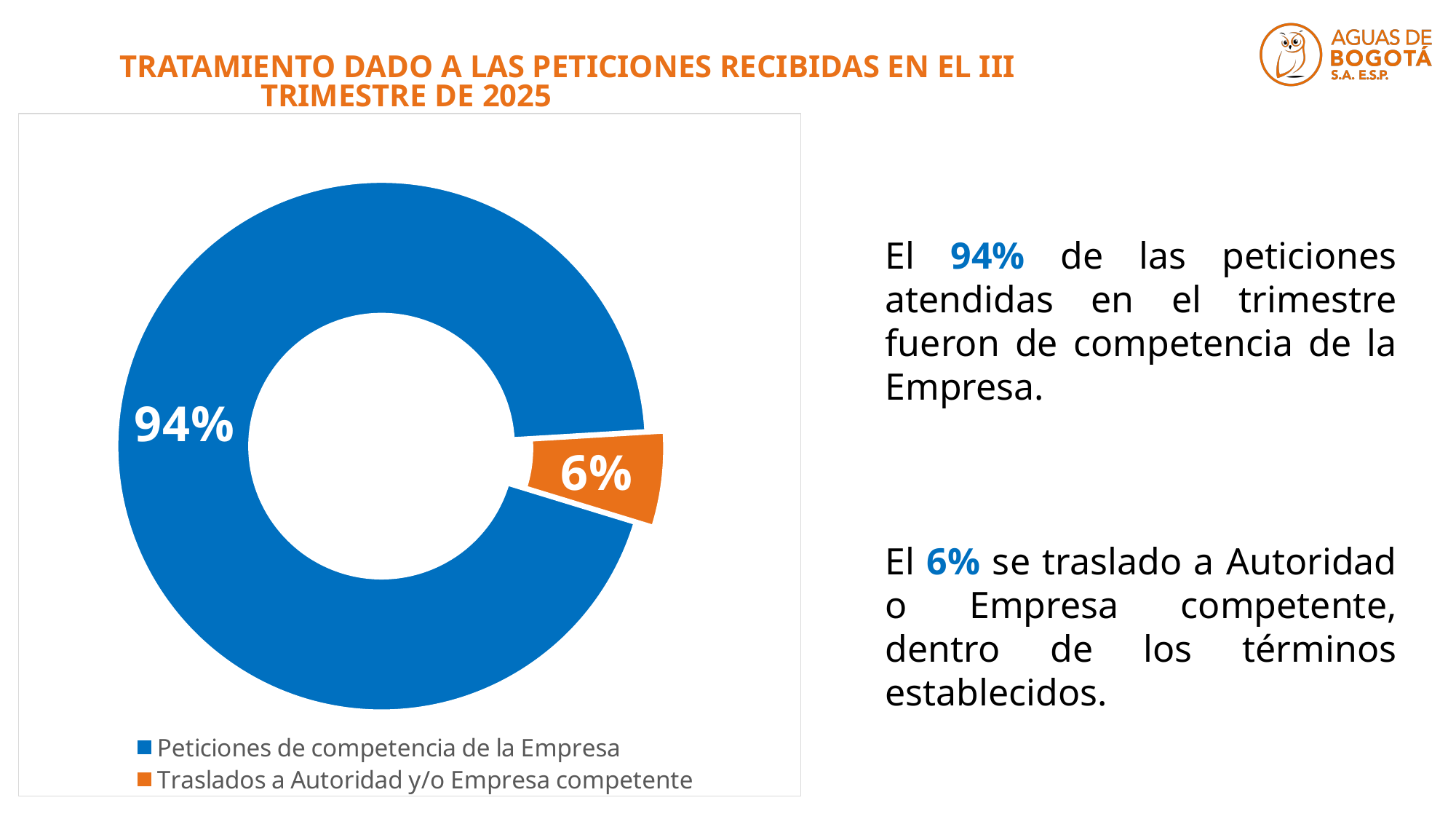
What is the difference in percentage points between the 'Peticiones de competencia de la Empresa' slice and the 'Traslados a Autoridad y/o Empresa competente' slice? 88 What colour is the slice for 'Traslados a Autoridad y/o Empresa competente'? Orange What colour is the slice for 'Peticiones de competencia de la Empresa'? Blue What is the total of the two slices shown in the pie chart? 100% Which category has the smallest slice of the pie? Traslados a Autoridad y/o Empresa competente What kind of chart is shown on the slide? Pie chart (doughnut) What share of the pie is labelled 'Peticiones de competencia de la Empresa'? 94% Which category has the largest slice of the pie? Peticiones de competencia de la Empresa How many categories does the pie chart show? 2 Which is larger: the slice for 'Peticiones de competencia de la Empresa' or the slice for 'Traslados a Autoridad y/o Empresa competente'? Peticiones de competencia de la Empresa What share of the pie is labelled 'Traslados a Autoridad y/o Empresa competente'? 6% How many entries does the legend list? 2